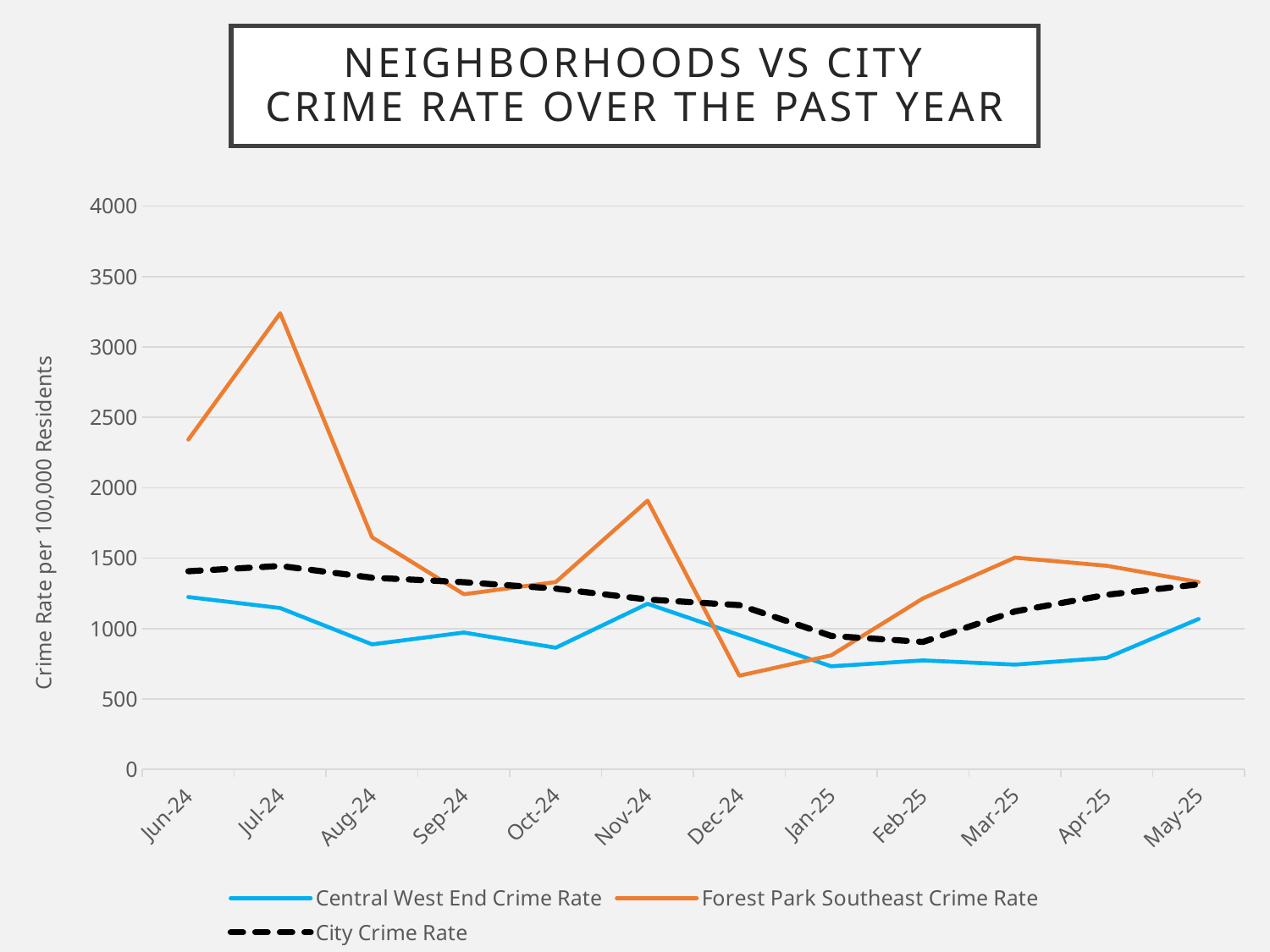
Is the Central West End Crime Rate for Aug-24 greater or less than 1000? less How many months are plotted along the x axis? 12 In which month is the Forest Park Southeast Crime Rate highest? Jul-24 How many series does the legend list? 3 Does the Forest Park Southeast Crime Rate rise or fall from Jul-24 to Aug-24? fall What kind of chart is shown on the slide? line chart In which month is the Forest Park Southeast Crime Rate lowest? Dec-24 In Dec-24, which is larger: the Central West End Crime Rate or the Forest Park Southeast Crime Rate? Central West End Crime Rate Is the Forest Park Southeast Crime Rate for Jul-24 greater or less than 3000? greater In Jan-25, which is larger: the City Crime Rate or the Central West End Crime Rate? City Crime Rate What is the label on the vertical axis? Crime Rate per 100,000 Residents Is the Forest Park Southeast Crime Rate for Nov-24 greater or less than 1500? greater